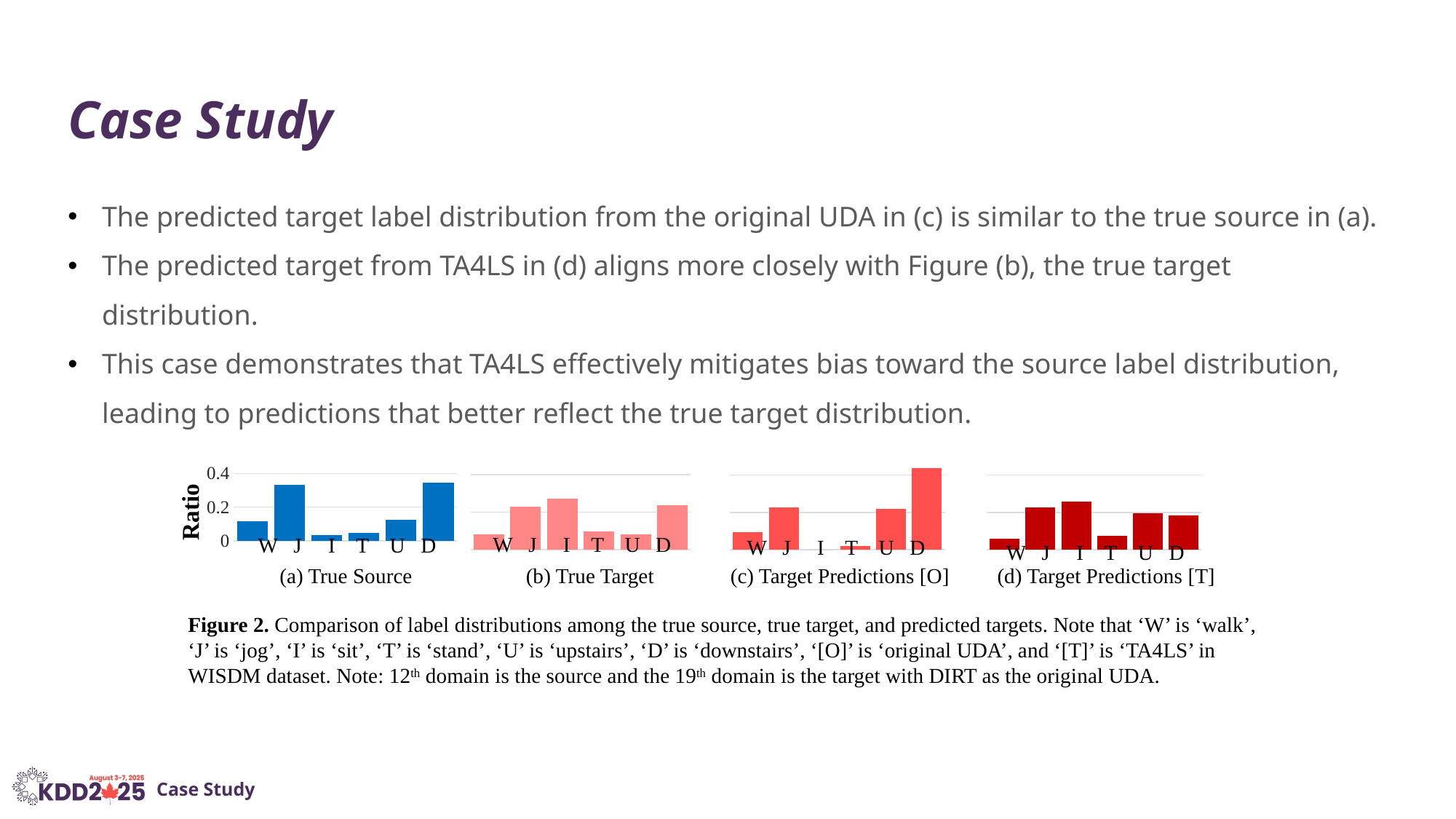
In the (d) Target Predictions [T] chart, which is larger, the value for J or the value for T? J In the (b) True Target chart, which is larger, the value for I or the value for W? I In the (c) Target Predictions [O] chart, which category has the highest value? D How many categories are plotted in the (c) Target Predictions [O] chart? 6 What kind of chart is shown in panel (a) True Source? bar chart How many bar charts are shown in Figure 2 on the slide? 4 In the (a) True Source chart, is the value for J greater or less than 0.2? greater In the (c) Target Predictions [O] chart, is the value for D greater or less than 0.4? greater In the (a) True Source chart, is the value for I greater or less than 0.2? less In the (c) Target Predictions [O] chart, which category has the lowest value? I What is the label on the y axis of the (a) True Source chart? Ratio